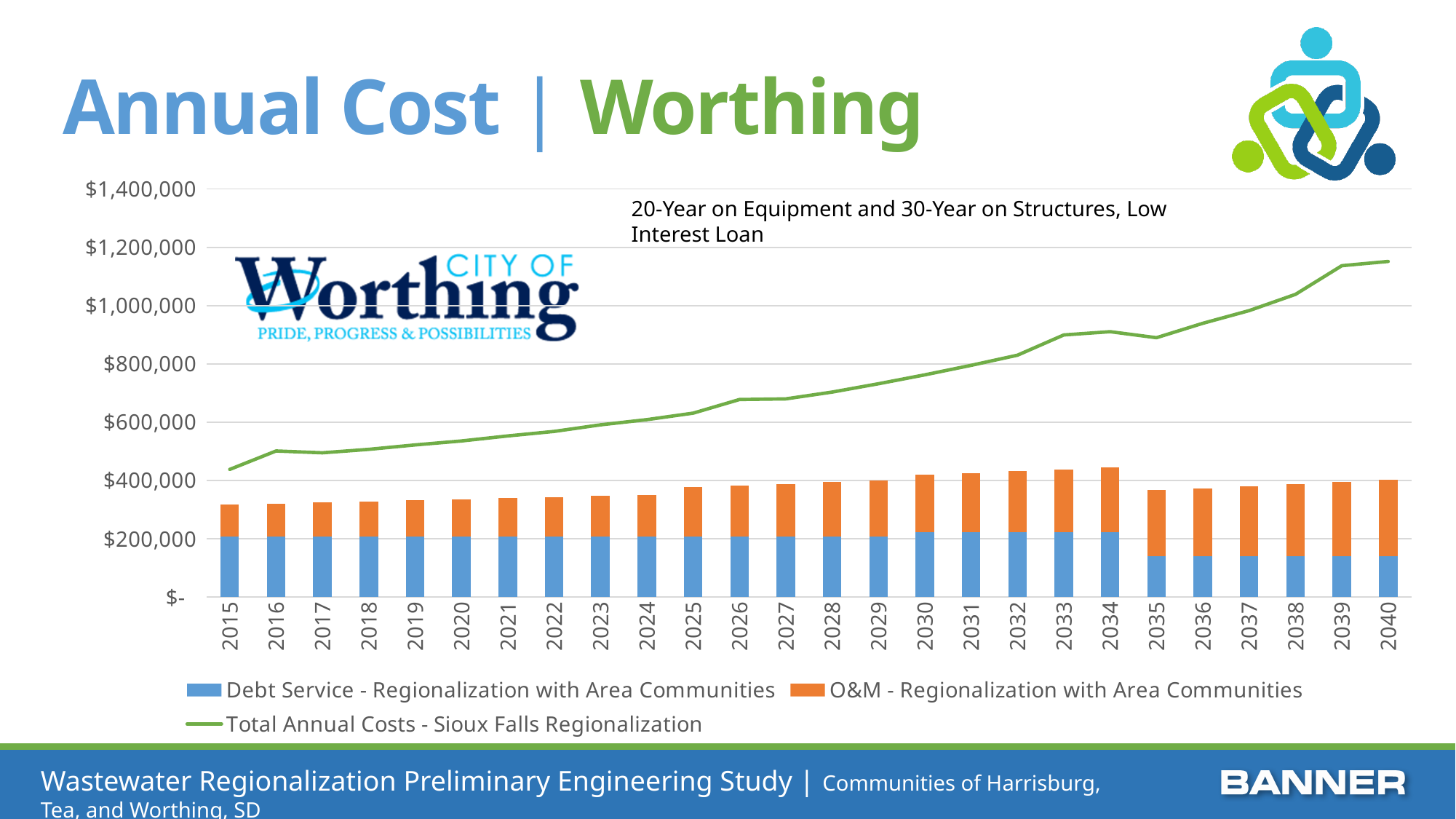
Is the Total Annual Costs - Sioux Falls Regionalization value for 2040 greater or less than $1,000,000? greater In which year is the Total Annual Costs - Sioux Falls Regionalization line at its highest? 2040 What kind of chart is shown on the slide? A combined bar and line chart (stacked bars with a line) Is the Debt Service - Regionalization with Area Communities value for 2035 greater or less than $200,000? less In which year is the Total Annual Costs - Sioux Falls Regionalization line at its lowest? 2015 Is the Total Annual Costs - Sioux Falls Regionalization value for 2015 greater or less than $600,000? less What is the first year shown on the x axis? 2015 How many series does the legend list? 3 How many years are shown along the x axis? 26 Does the Total Annual Costs - Sioux Falls Regionalization line generally rise or fall from 2015 to 2040? Rise In 2040, which is larger: the Total Annual Costs - Sioux Falls Regionalization line or the stacked bar for Regionalization with Area Communities? Total Annual Costs - Sioux Falls Regionalization line